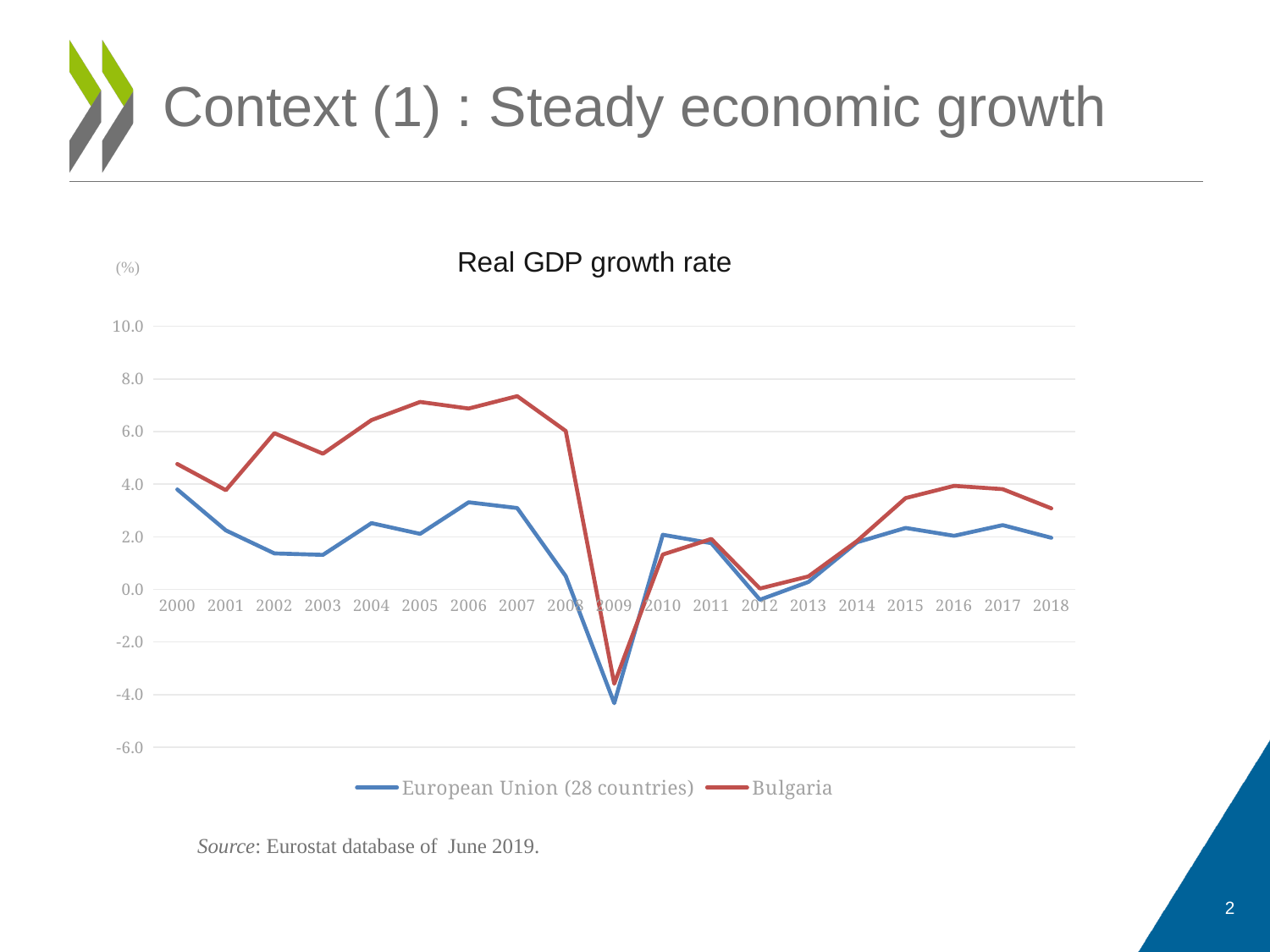
In which year does Bulgaria's real GDP growth rate reach its lowest point? 2009 Does the European Union (28 countries) real GDP growth rate rise or fall from 2007 to 2009? fall In which year does the European Union (28 countries) real GDP growth rate reach its lowest point? 2009 Is Bulgaria's real GDP growth rate in 2007 greater or less than 6.0? greater Is the European Union (28 countries) real GDP growth rate in 2009 greater or less than -2.0? less How many years are plotted along the x axis? 19 In 2007, which has the higher real GDP growth rate: Bulgaria or the European Union (28 countries)? Bulgaria How many series does the legend list? 2 What kind of chart is shown on the slide? line chart In 2009, which has the lower real GDP growth rate: Bulgaria or the European Union (28 countries)? European Union (28 countries) Is Bulgaria's real GDP growth rate in 2012 greater or less than 2.0? less What is the title of the chart? Real GDP growth rate